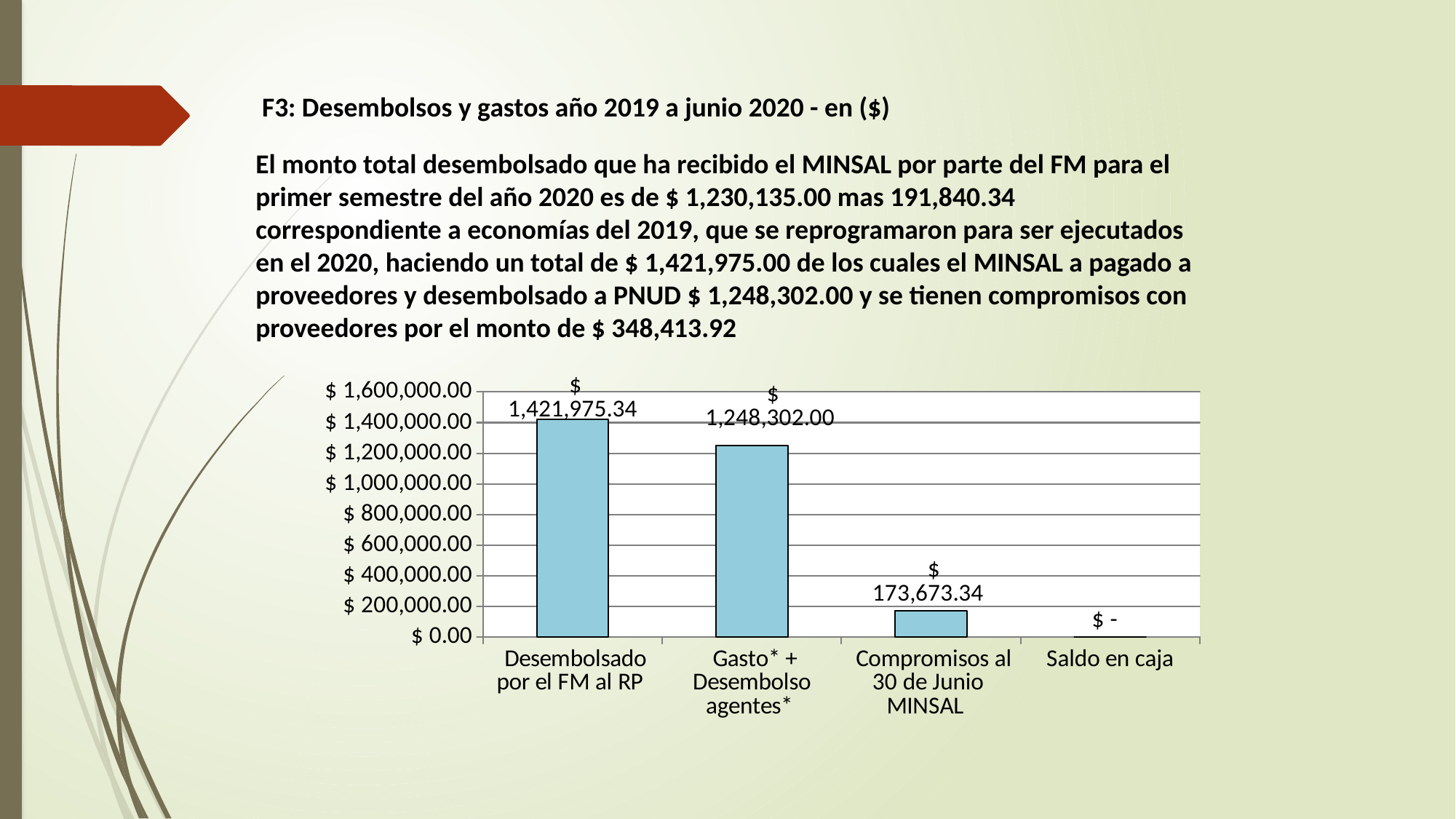
What kind of chart is shown on the slide? Bar chart Which is larger, "Gasto* + Desembolso agentes*" or "Compromisos al 30 de Junio MINSAL"? Gasto* + Desembolso agentes* What is the value for "Compromisos al 30 de Junio MINSAL"? $ 173,673.34 What is the value for "Gasto* + Desembolso agentes*"? $ 1,248,302.00 What is the data label shown for "Saldo en caja"? $ - What is the value for "Desembolsado por el FM al RP"? $ 1,421,975.34 Which category has the lowest value? Saldo en caja Which category has the highest value? Desembolsado por el FM al RP Is the value for "Compromisos al 30 de Junio MINSAL" greater or less than $ 200,000.00? less What is the difference between "Gasto* + Desembolso agentes*" and "Compromisos al 30 de Junio MINSAL"? $ 1,074,628.66 How many categories are shown on the x axis of the chart? 4 What is the difference between "Desembolsado por el FM al RP" and "Gasto* + Desembolso agentes*"? $ 173,673.34